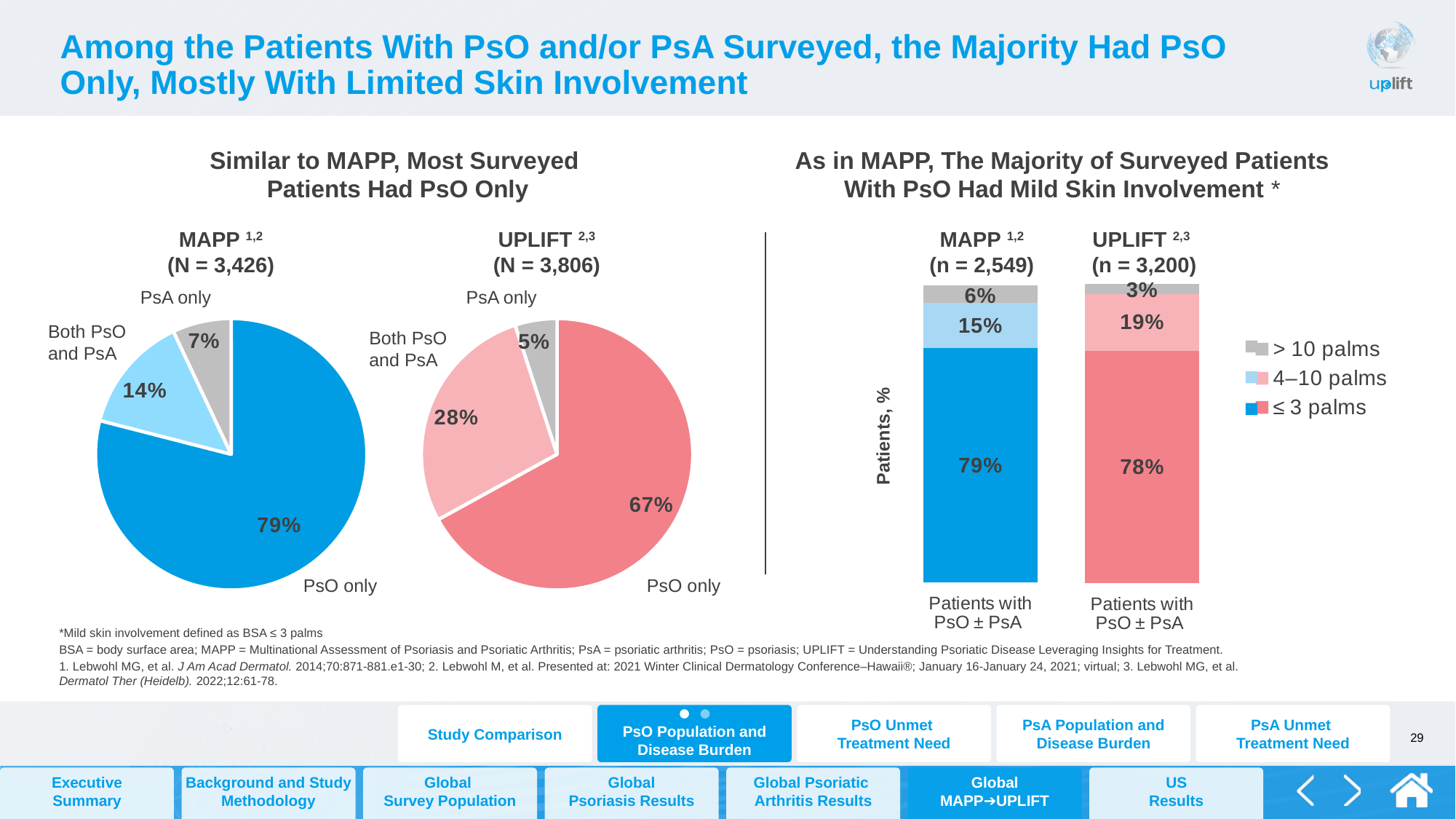
In the stacked bar chart on the right, what percentage of MAPP patients had ≤ 3 palms of skin involvement? 79% What is the difference between the 'Both PsO and PsA' share in the UPLIFT pie chart and in the MAPP pie chart? 14% How many slices does the MAPP pie chart (N = 3,426) have? 3 In the UPLIFT pie chart (N = 3,806), what percentage of patients had PsA only? 5% In the stacked bar chart on the right, which is larger: the 4–10 palms share for MAPP or for UPLIFT? UPLIFT What type of chart is used on the right side of the slide to show skin involvement? Stacked bar chart How many series does the legend of the stacked bar chart on the right list? 3 In the UPLIFT pie chart (N = 3,806), what percentage of patients had both PsO and PsA? 28% In the MAPP pie chart (N = 3,426), which category has the smallest share? PsA only In the MAPP pie chart (N = 3,426), what percentage of patients had PsO only? 79% In the stacked bar chart on the right, what percentage of UPLIFT patients had > 10 palms of skin involvement? 3% In the UPLIFT pie chart (N = 3,806), which category has the largest share? PsO only